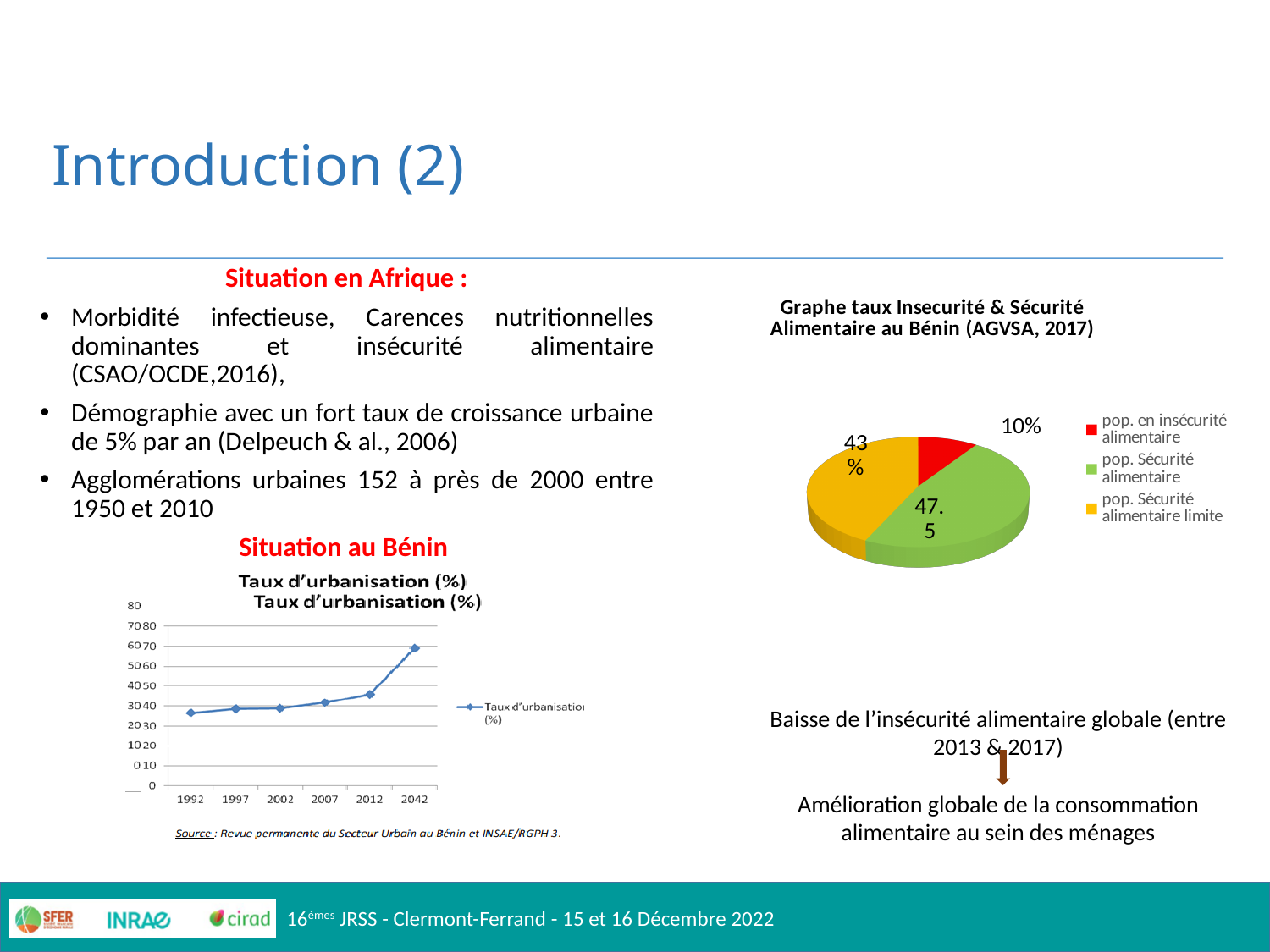
In the 'Taux d'urbanisation (%)' chart, do the values rise or fall from 1992 to 2042? rise In the pie chart 'Graphe taux Insecurité & Sécurité Alimentaire au Bénin (AGVSA, 2017)', which category has the smallest slice? pop. en insécurité alimentaire What kind of chart is the 'Graphe taux Insecurité & Sécurité Alimentaire au Bénin (AGVSA, 2017)' chart? pie chart In the pie chart 'Graphe taux Insecurité & Sécurité Alimentaire au Bénin (AGVSA, 2017)', what value is shown for 'pop. Sécurité alimentaire limite'? 43% How many years are shown on the x axis of the 'Taux d'urbanisation (%)' chart? 6 What kind of chart is the 'Taux d'urbanisation (%)' chart on the left of the slide? line chart In the pie chart 'Graphe taux Insecurité & Sécurité Alimentaire au Bénin (AGVSA, 2017)', which category has the largest slice? pop. Sécurité alimentaire In the 'Taux d'urbanisation (%)' chart, is the value for 1992 greater or less than 40? less In the pie chart 'Graphe taux Insecurité & Sécurité Alimentaire au Bénin (AGVSA, 2017)', what value is shown for 'pop. Sécurité alimentaire'? 47.5 In the pie chart 'Graphe taux Insecurité & Sécurité Alimentaire au Bénin (AGVSA, 2017)', what value is shown for 'pop. en insécurité alimentaire'? 10% How many entries does the legend of the pie chart 'Graphe taux Insecurité & Sécurité Alimentaire au Bénin (AGVSA, 2017)' list? 3